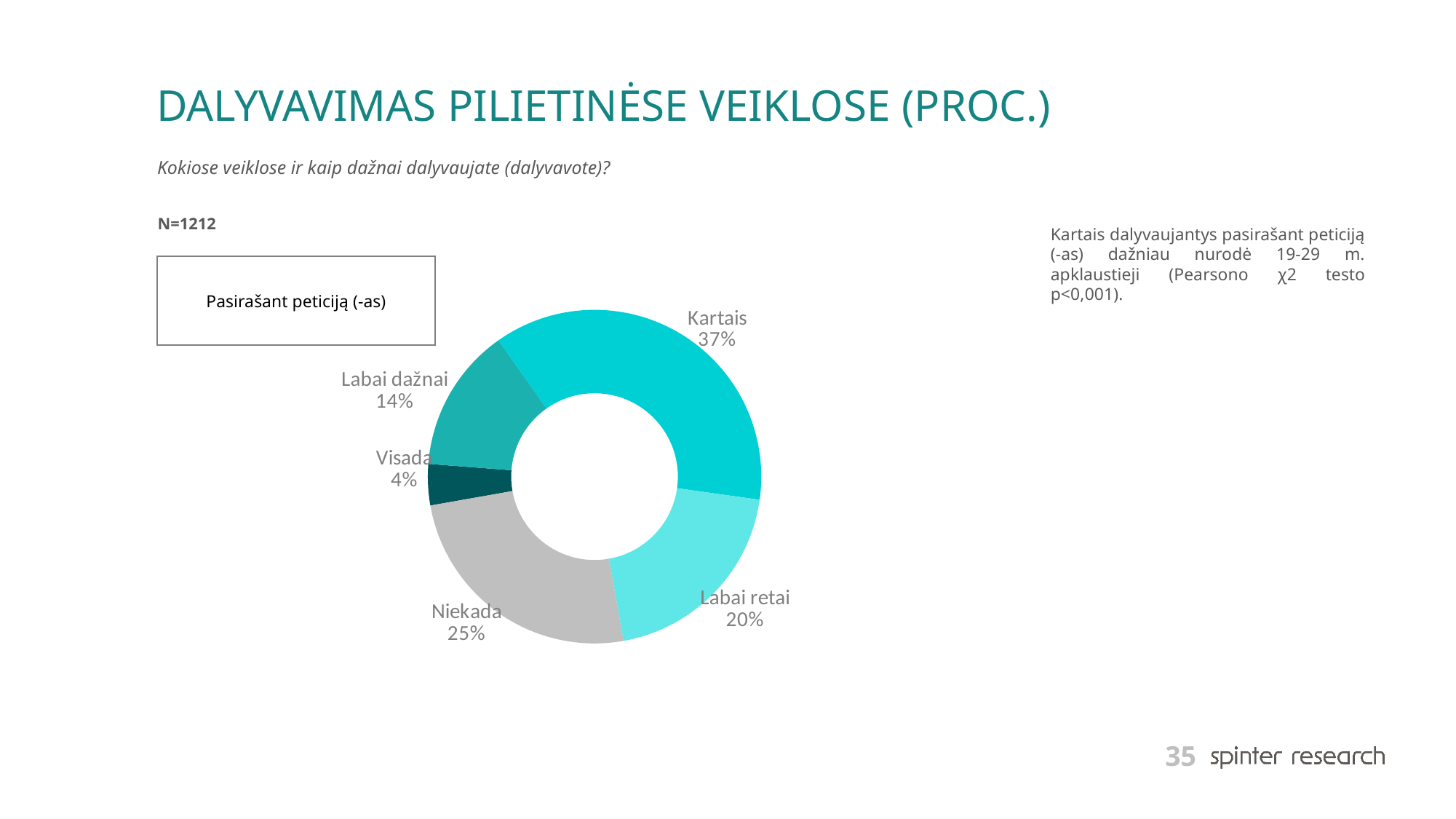
What is the value shown for "Labai retai"? 20% What share of the pie is labelled "Niekada"? 25% What is the difference in percentage points between "Kartais" and "Niekada"? 12 What is the combined share of "Labai dažnai" and "Visada"? 18% What activity does the chart refer to, according to the box next to it? Pasirašant peticiją (-as) What is the value shown for "Visada"? 4% Which category has the smallest slice of the pie? Visada Which category has the largest slice of the pie? Kartais How many categories are shown in the pie chart? 5 What kind of chart is shown on the slide? Pie chart (doughnut) What percentage of respondents answered "Kartais" for Pasirašant peticiją (-as)? 37% Which is larger, the slice for "Labai dažnai" or the slice for "Labai retai"? Labai retai